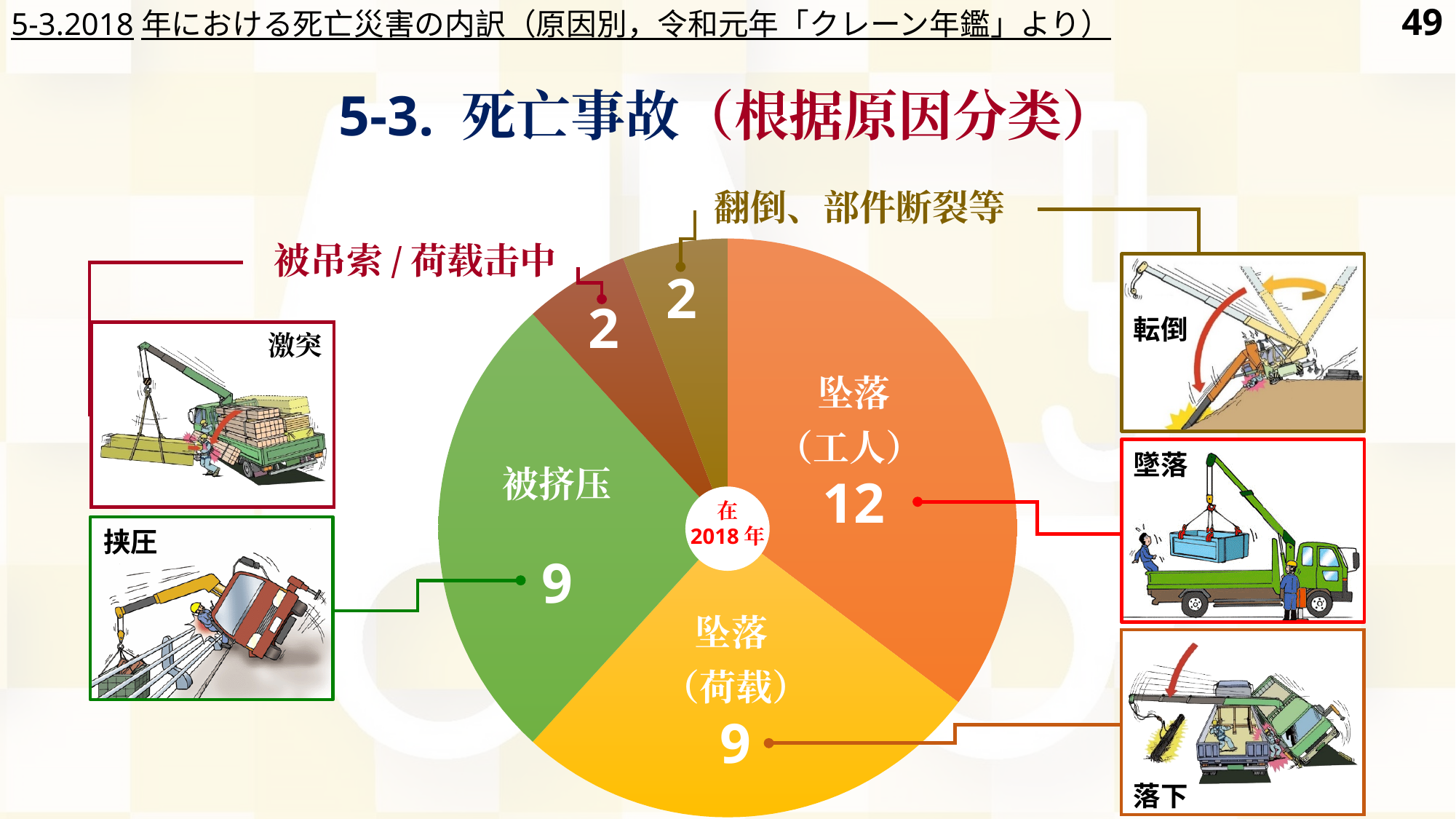
What is the sum of all values shown in the pie chart? 34 What is the difference between the values for 坠落（工人） and 坠落（荷载）? 3 What type of chart is shown on the slide? pie chart What is the value for 被挤压 in the pie chart? 9 What is the value for 被吊索 / 荷载击中 in the pie chart? 2 What is the value for 坠落（荷载） in the pie chart? 9 What is the value for 坠落（工人） in the pie chart? 12 Which is larger, 坠落（工人） or 被挤压? 坠落（工人） Which category has the largest slice in the pie chart? 坠落（工人） How many categories does the pie chart have? 5 What year is written in the centre of the pie chart? 2018年 What is the value for 翻倒、部件断裂等 in the pie chart? 2